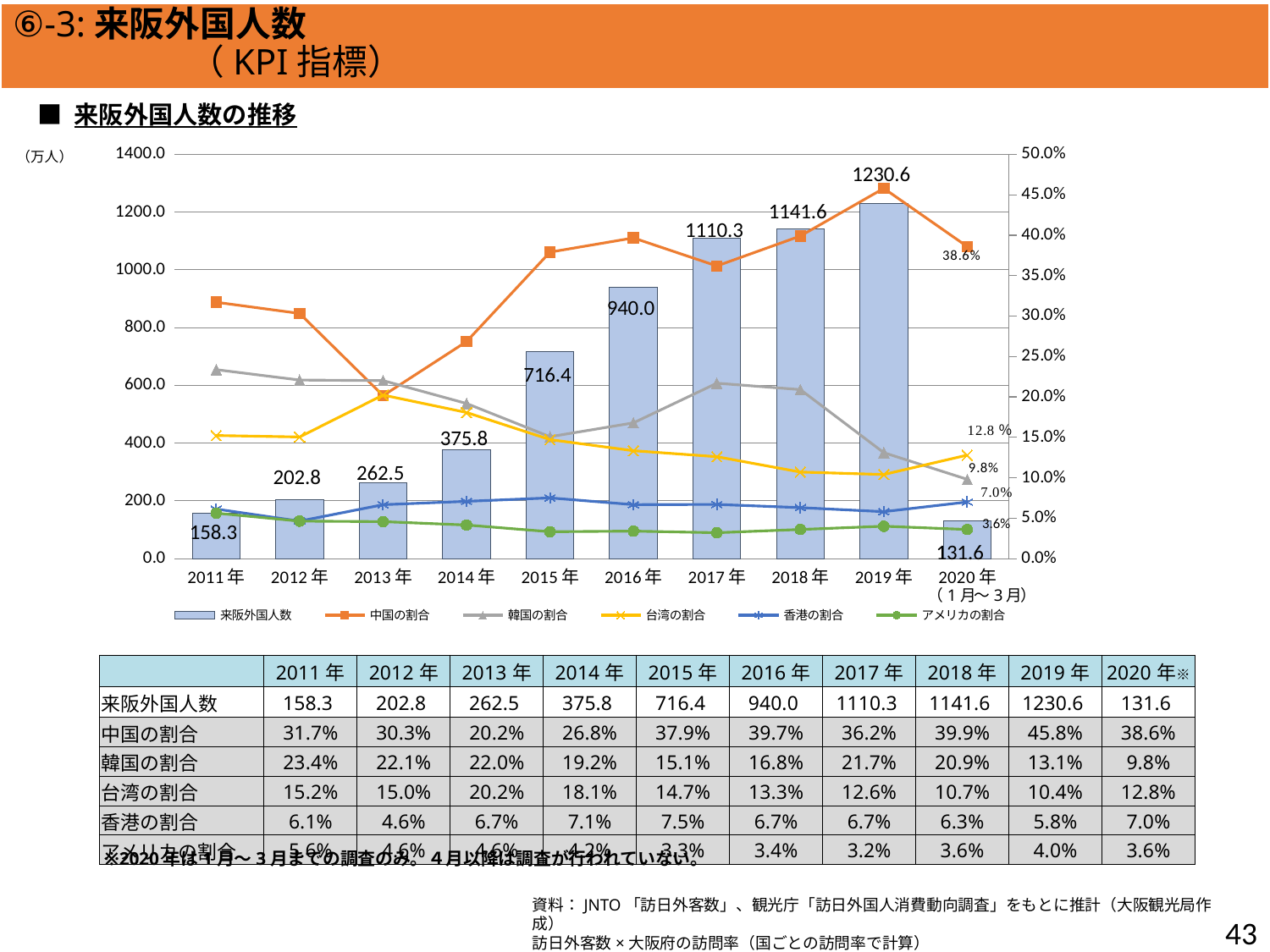
What is the value of 来阪外国人数 for 2016年? 940.0 Does the 来阪外国人数 value rise or fall from 2011年 to 2019年? rise Is the 中国の割合 value for 2019年 greater or less than 40.0%? greater What is the difference between the 来阪外国人数 values for 2018年 and 2017年? 31.3 How many series does the chart legend list? 6 In which year is the 来阪外国人数 bar the highest? 2019年 What is the 中国の割合 value labelled for 2020年（1月～3月）? 38.6% Which year has the larger 来阪外国人数 value, 2014年 or 2015年? 2015年 How many periods are shown on the x axis of the chart? 10 What is the value of 来阪外国人数 for 2019年? 1230.6 What kind of chart is shown on the slide? Combined bar and line chart In which period is the 来阪外国人数 bar the lowest? 2020年（1月～3月）